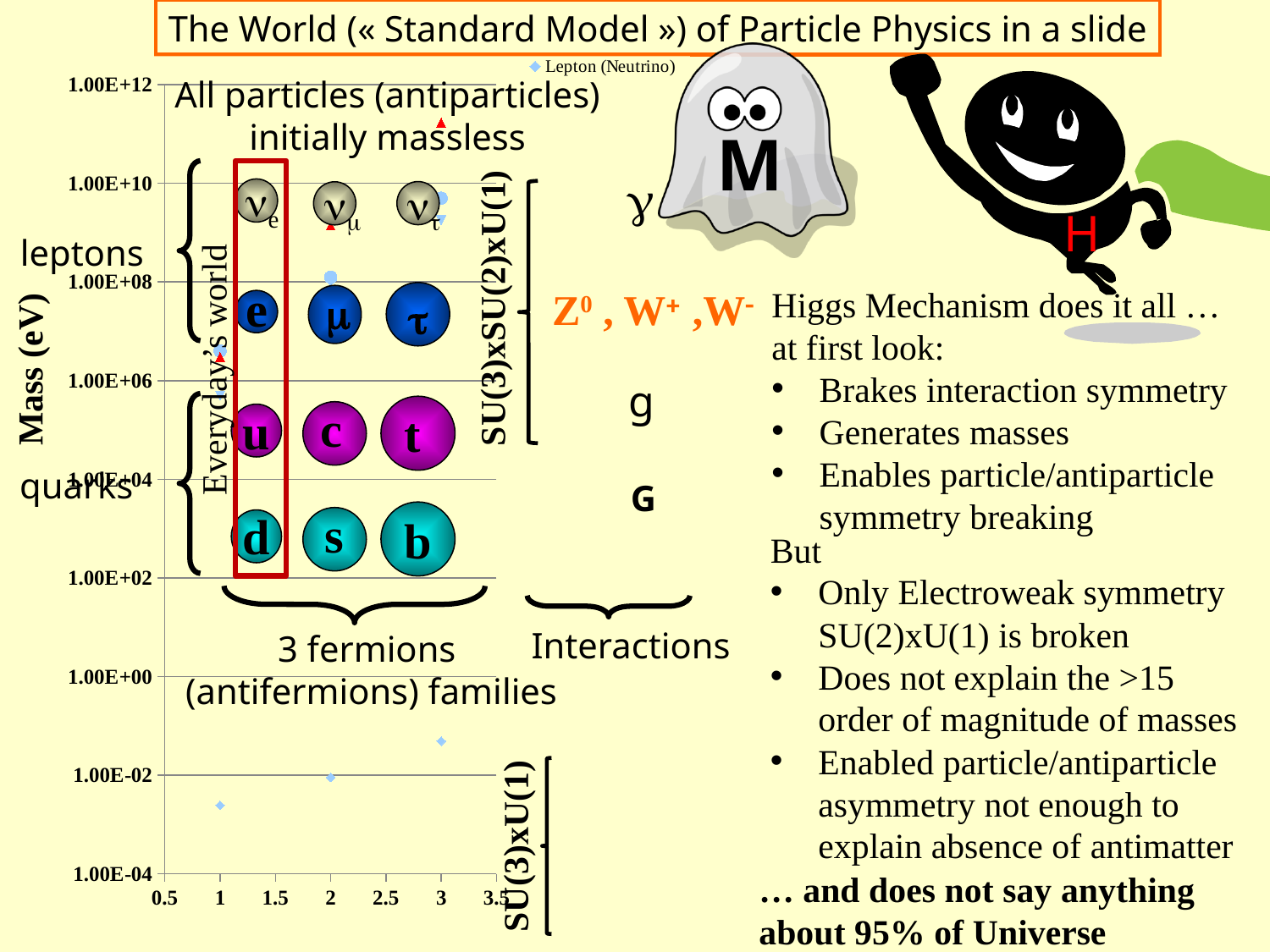
Is the Lepton (Neutrino) value at x = 3 greater or less than 1.00E+02? less What kind of chart is shown on the left of the slide? scatter chart Which Lepton (Neutrino) point has the highest mass value: x = 1, x = 2 or x = 3? x = 3 How many Lepton (Neutrino) points are plotted on the chart? 3 Is the Lepton (Neutrino) value at x = 2 greater or less than 1.00E+00? less What is the title of the vertical axis of the chart? Mass (eV) Which Lepton (Neutrino) point has the lowest mass value: x = 1, x = 2 or x = 3? x = 1 Do the Lepton (Neutrino) values rise or fall as x increases from 1 to 3? rise What series name is shown in the chart's legend? Lepton (Neutrino) Is the Lepton (Neutrino) value at x = 1 greater or less than 1.00E+00? less Is the Lepton (Neutrino) value at x = 3 larger or smaller than the value at x = 1? larger